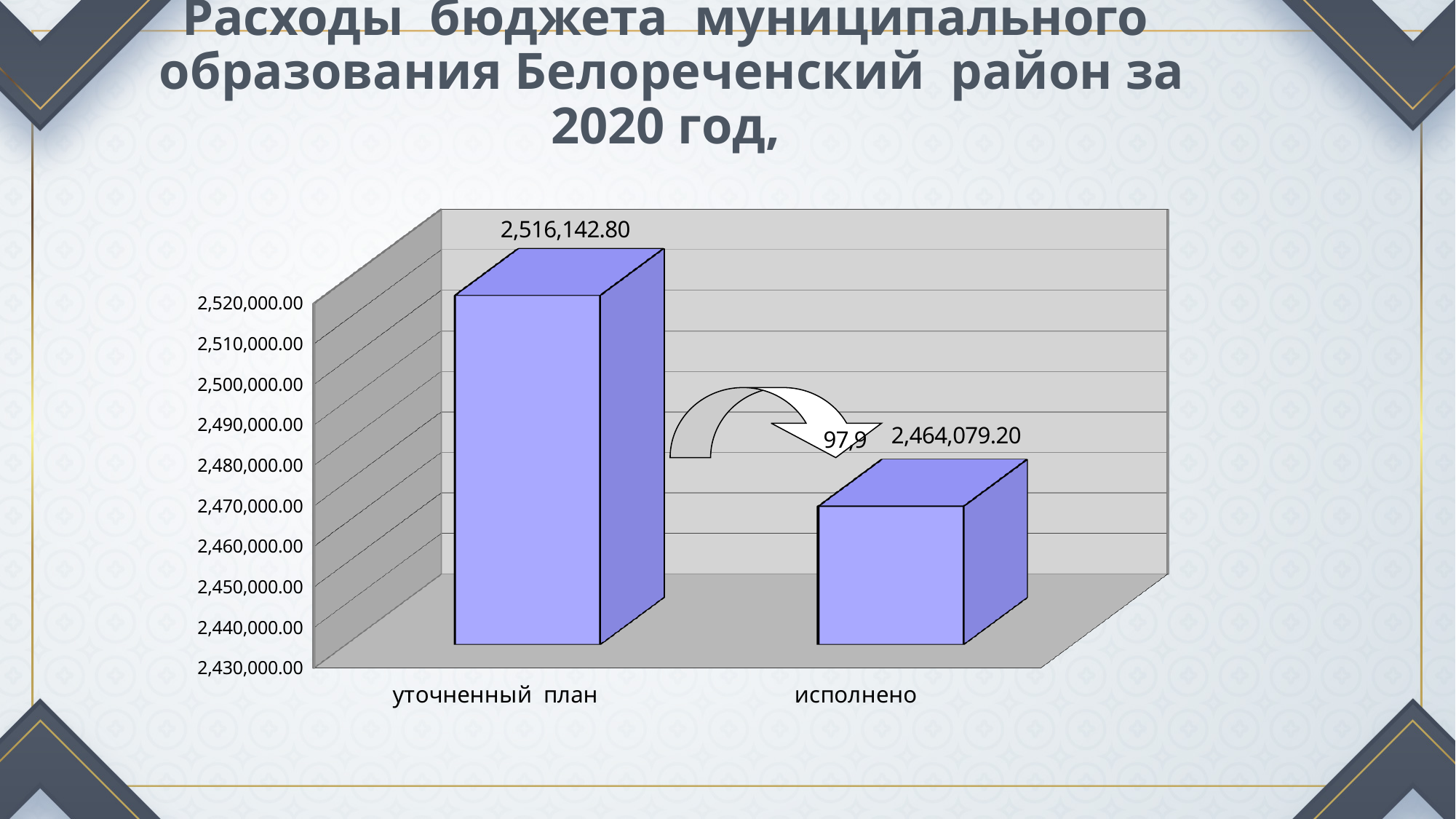
How many categories are shown on the x axis? 2 Which category has the highest value? уточненный план Is the value for "исполнено" greater or less than 2,500,000.00? less What number is written on the arrow between the two bars? 97,9 What is the value for "исполнено"? 2,464,079.20 What is the value for "уточненный план"? 2,516,142.80 Which category has the lowest value? исполнено Which is larger, the value for "уточненный план" or the value for "исполнено"? уточненный план What is the difference between the values for "уточненный план" and "исполнено"? 52,063.60 Do the values rise or fall from "уточненный план" to "исполнено"? fall What kind of chart is shown on the slide? bar chart Is the value for "уточненный план" greater or less than 2,500,000.00? greater